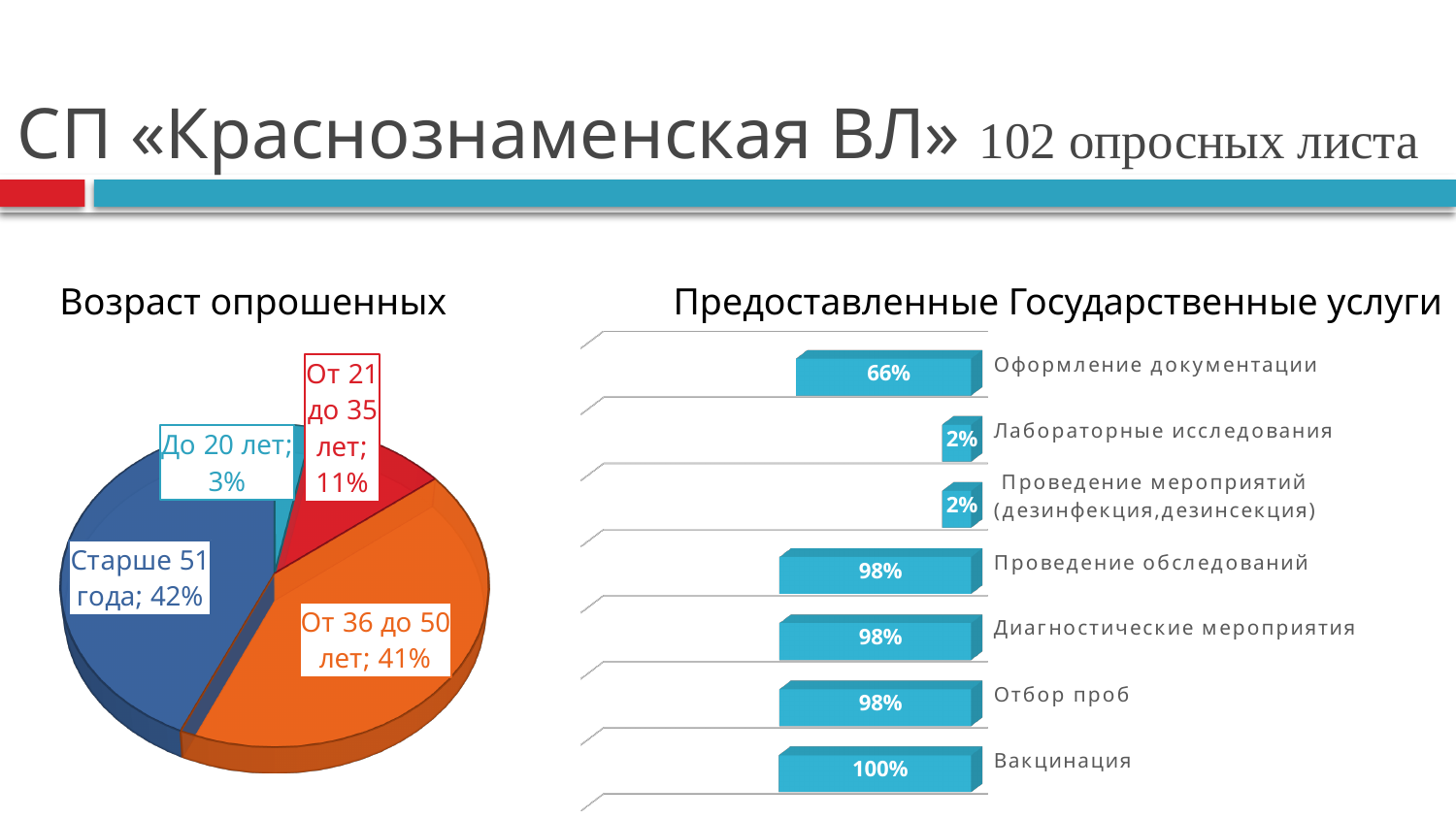
In the 'Предоставленные Государственные услуги' chart, what is the value for 'Оформление документации'? 66% In the 'Предоставленные Государственные услуги' chart, how many services are listed? 7 In the 'Возраст опрошенных' chart, how many age groups are shown? 4 In the 'Возраст опрошенных' chart, what share of respondents are 'До 20 лет'? 3% In the 'Предоставленные Государственные услуги' chart, which service has the highest value? Вакцинация What kind of chart is 'Возраст опрошенных'? Pie chart What kind of chart is 'Предоставленные Государственные услуги'? Bar chart In the 'Возраст опрошенных' chart, what share of respondents are 'Старше 51 года'? 42% In the 'Возраст опрошенных' chart, which age group has the largest share? Старше 51 года In the 'Предоставленные Государственные услуги' chart, what is the value for 'Вакцинация'? 100% In the 'Возраст опрошенных' chart, which age group has the smallest share? До 20 лет In the 'Предоставленные Государственные услуги' chart, what is the difference between 'Вакцинация' and 'Оформление документации'? 34%